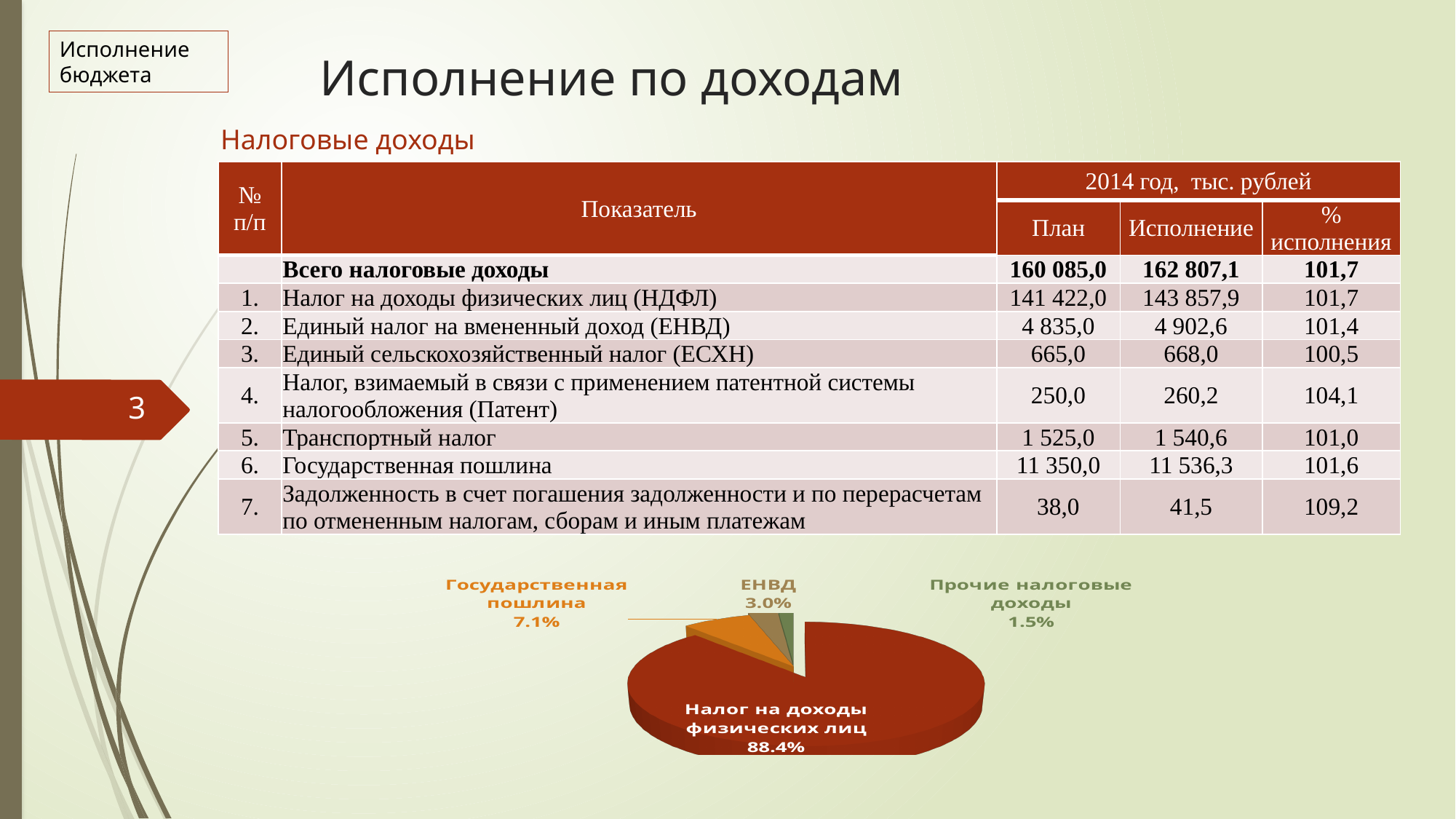
How many slices does the pie chart have? 4 In the pie chart, which is larger: Государственная пошлина or ЕНВД? Государственная пошлина In the pie chart, what is the difference in percentage points between Государственная пошлина and ЕНВД? 4.1 Which slice of the pie chart is the largest? Налог на доходы физических лиц What share of the pie chart does Государственная пошлина have? 7.1% What share of the pie chart does Налог на доходы физических лиц have? 88.4% What colour is the largest slice of the pie chart? Dark red Which slice of the pie chart is the smallest? Прочие налоговые доходы What share of the pie chart does ЕНВД have? 3.0% What kind of chart is shown at the bottom of the slide? Pie chart In the pie chart, what is the difference in percentage points between ЕНВД and Прочие налоговые доходы? 1.5